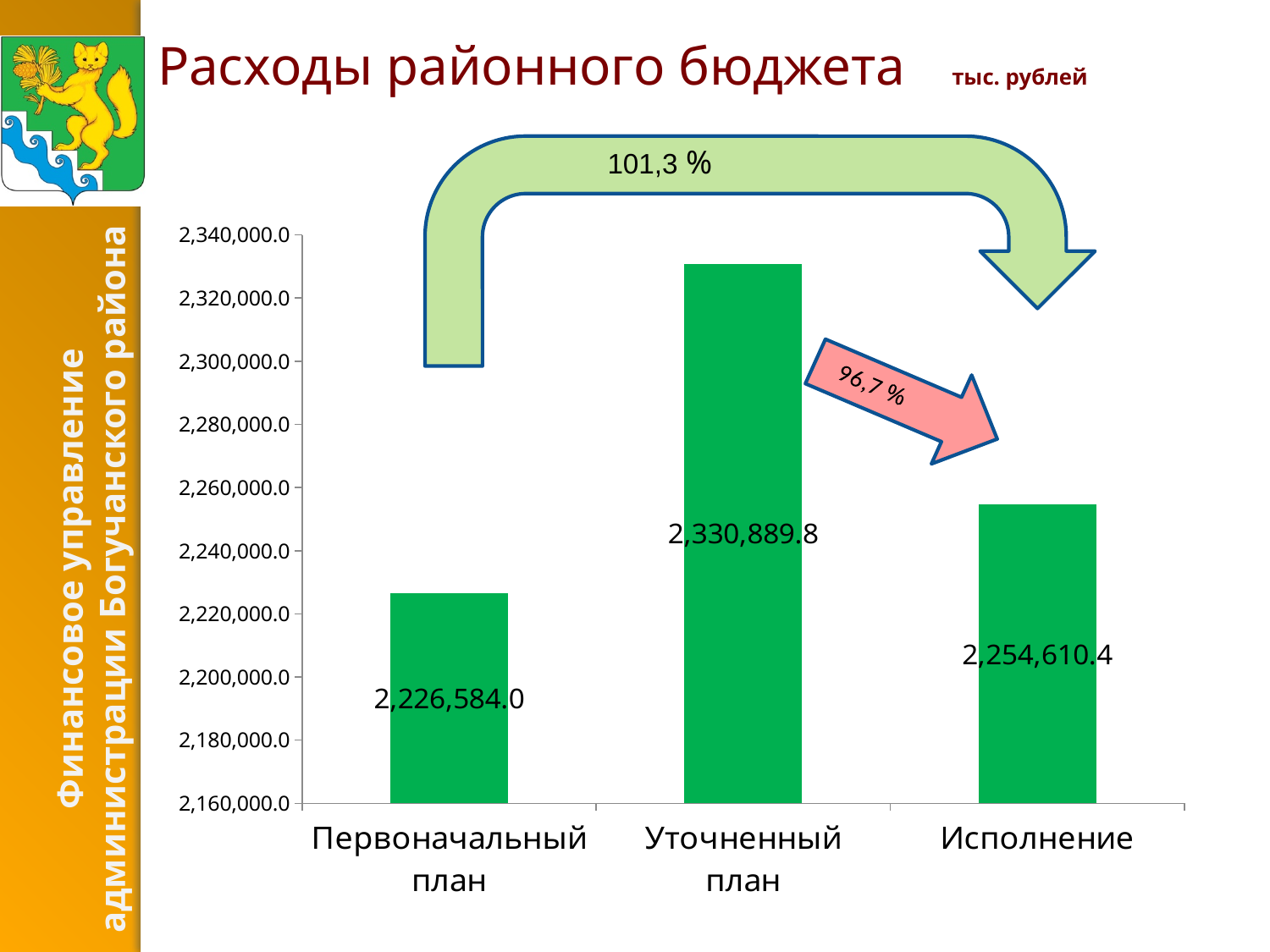
What is the difference between Уточненный план and Исполнение? 76,279.4 Is the value for Исполнение greater or less than 2,260,000.0? less What is the difference between Уточненный план and Первоначальный план? 104,305.8 What is the title of the chart? Расходы районного бюджета Which category has the highest value? Уточненный план What is the value for Уточненный план? 2,330,889.8 What kind of chart is shown on the slide? bar chart What is the value for Первоначальный план? 2,226,584.0 Which category has the lowest value? Первоначальный план Which is larger, Исполнение or Первоначальный план? Исполнение How many categories are shown on the chart? 3 What is the value for Исполнение? 2,254,610.4